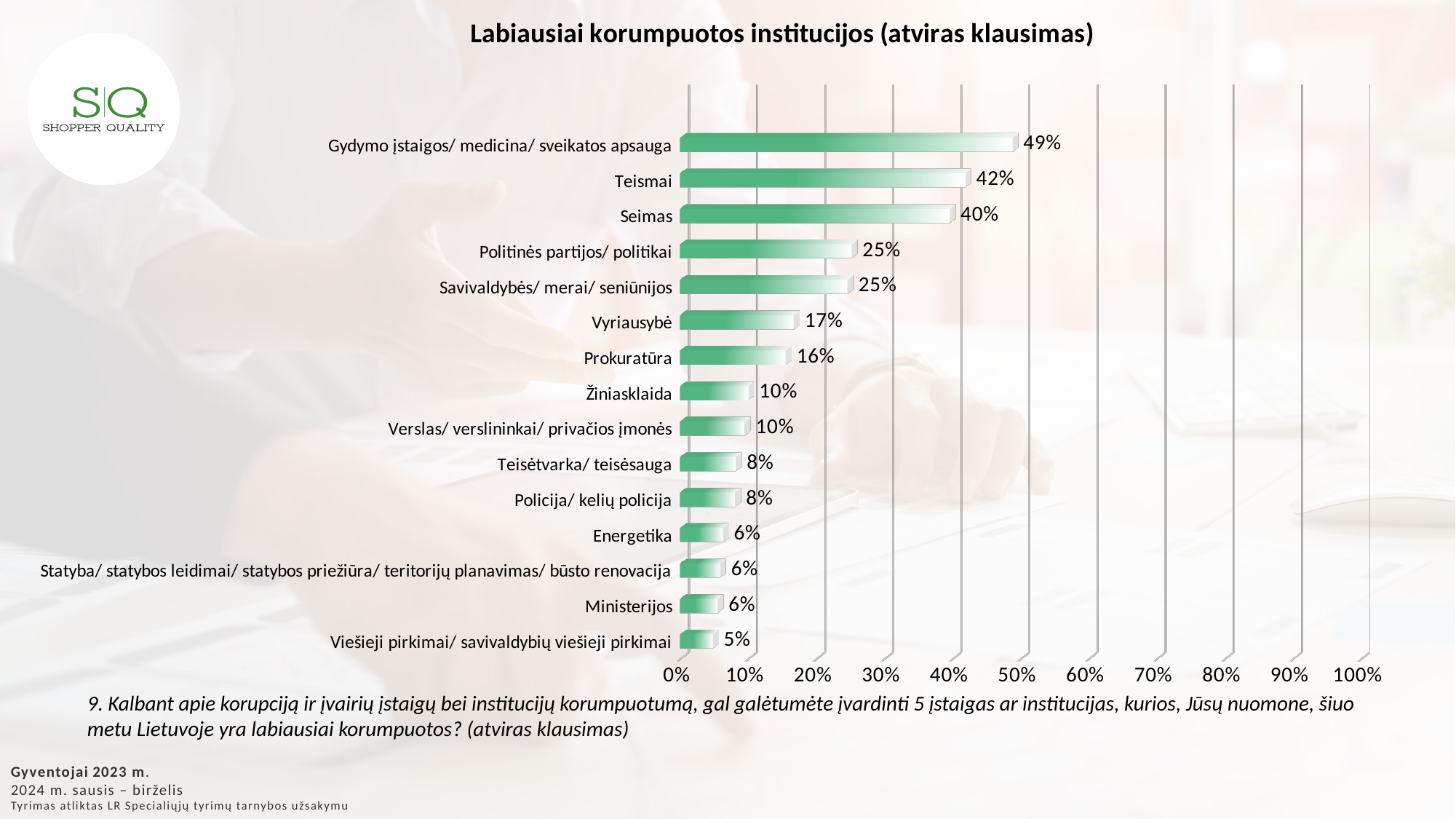
Which category has the lowest value? Viešieji pirkimai/ savivaldybių viešieji pirkimai What is the difference between the values for Prokuratūra and Žiniasklaida? 6% What is the title of the chart? Labiausiai korumpuotos institucijos (atviras klausimas) What is the value for Teismai? 42% What is the difference between the values for Gydymo įstaigos/ medicina/ sveikatos apsauga and Seimas? 9% Which category has the highest value? Gydymo įstaigos/ medicina/ sveikatos apsauga What is the value for Vyriausybė? 17% Which is larger, the value for Teismai or the value for Seimas? Teismai What kind of chart is shown on the slide? bar chart Is the value for Politinės partijos/ politikai greater or less than 20%? greater How many categories are shown in the chart? 15 What is the value for Energetika? 6%